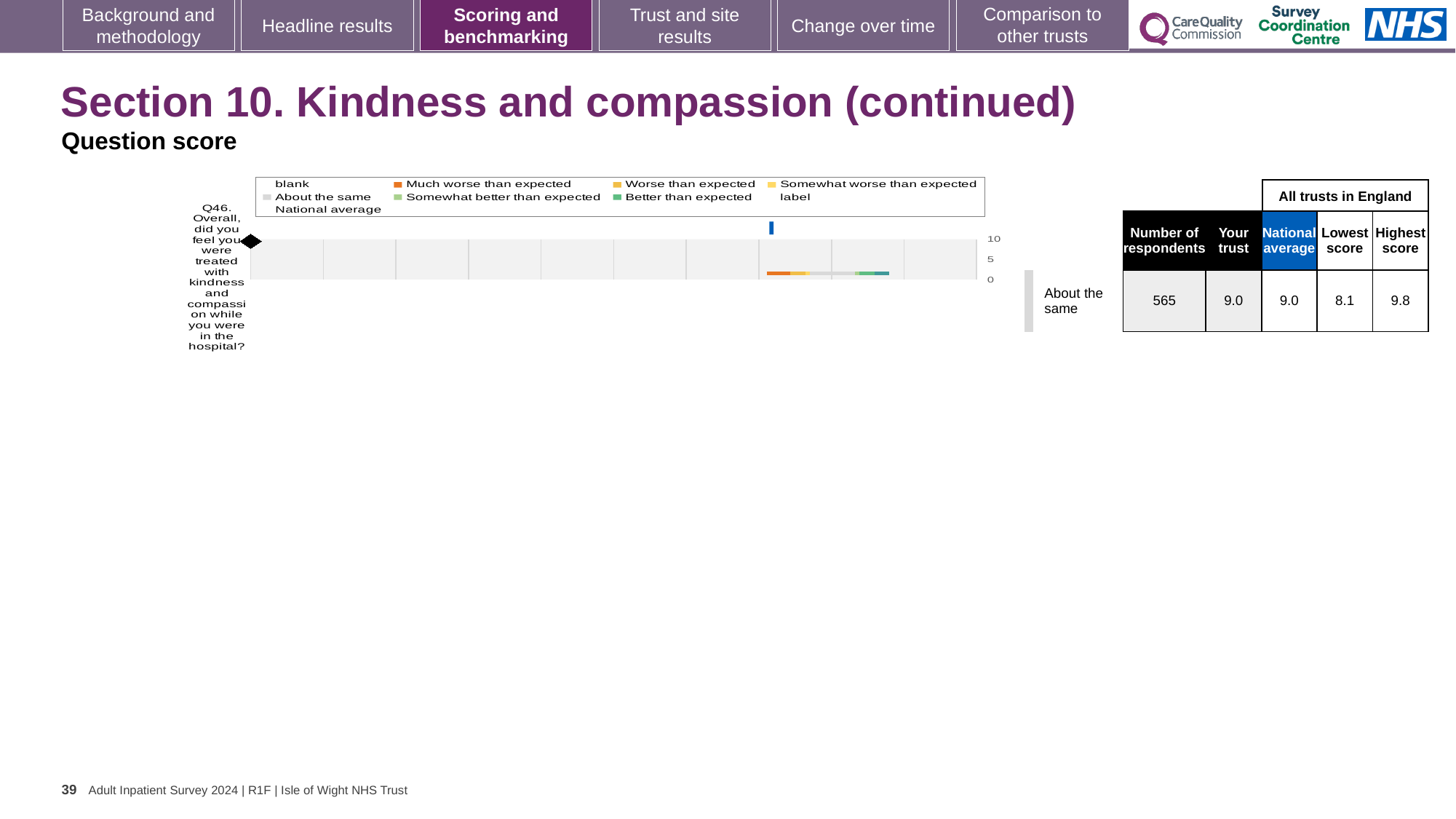
According to the table next to the chart, how many respondents answered Q46? 565 What is the maximum value shown on the chart's score axis? 10 What is the highest score among all trusts in England for Q46? 9.8 What is the difference between the highest score and the lowest score for Q46? 1.7 What is the lowest score among all trusts in England for Q46? 8.1 Is the 'Your trust' score for Q46 higher than, lower than, or the same as the national average? the same How many question categories are plotted on the chart? 1 What benchmark category label is shown for the trust's Q46 result? About the same What kind of chart is shown on the slide for Q46? bar chart What is the national average score for Q46 shown in the table? 9.0 By how much does the highest score for Q46 exceed the 'Your trust' score? 0.8 What is the 'Your trust' score for Q46 shown in the table? 9.0